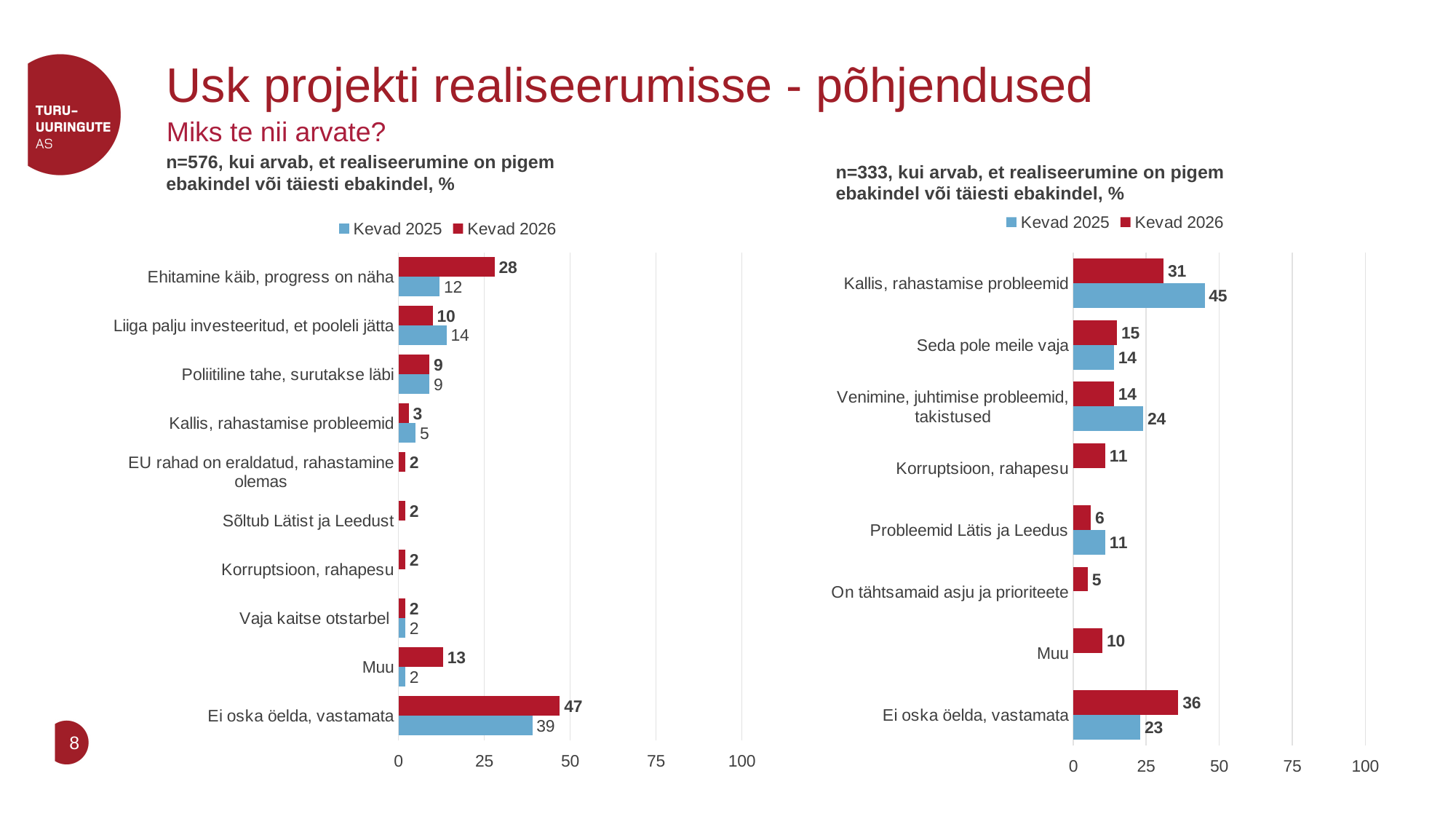
What type of chart is the left chart (n=576)? bar chart In the right chart (n=333), what is the difference between the Kevad 2025 and Kevad 2026 values for "Venimine, juhtimise probleemid, takistused"? 10 In the left chart (n=576), is the Kevad 2026 value for "Ei oska öelda, vastamata" greater or less than 25? greater In the right chart (n=333), which is larger for "Kallis, rahastamise probleemid": the Kevad 2025 value or the Kevad 2026 value? Kevad 2025 How many categories are shown in the left chart (n=576)? 10 In the right chart (n=333), which category has the highest Kevad 2026 value? Ei oska öelda, vastamata In the left chart (n=576), what is the difference between the Kevad 2026 and Kevad 2025 values for "Muu"? 11 In the left chart (n=576), what is the Kevad 2025 value for "Ei oska öelda, vastamata"? 39 In the left chart (n=576), what is the Kevad 2026 value for "Ehitamine käib, progress on näha"? 28 In the right chart (n=333), what is the Kevad 2025 value for "Kallis, rahastamise probleemid"? 45 How many series does the legend of the right chart (n=333) list? 2 How many categories are shown in the right chart (n=333)? 8